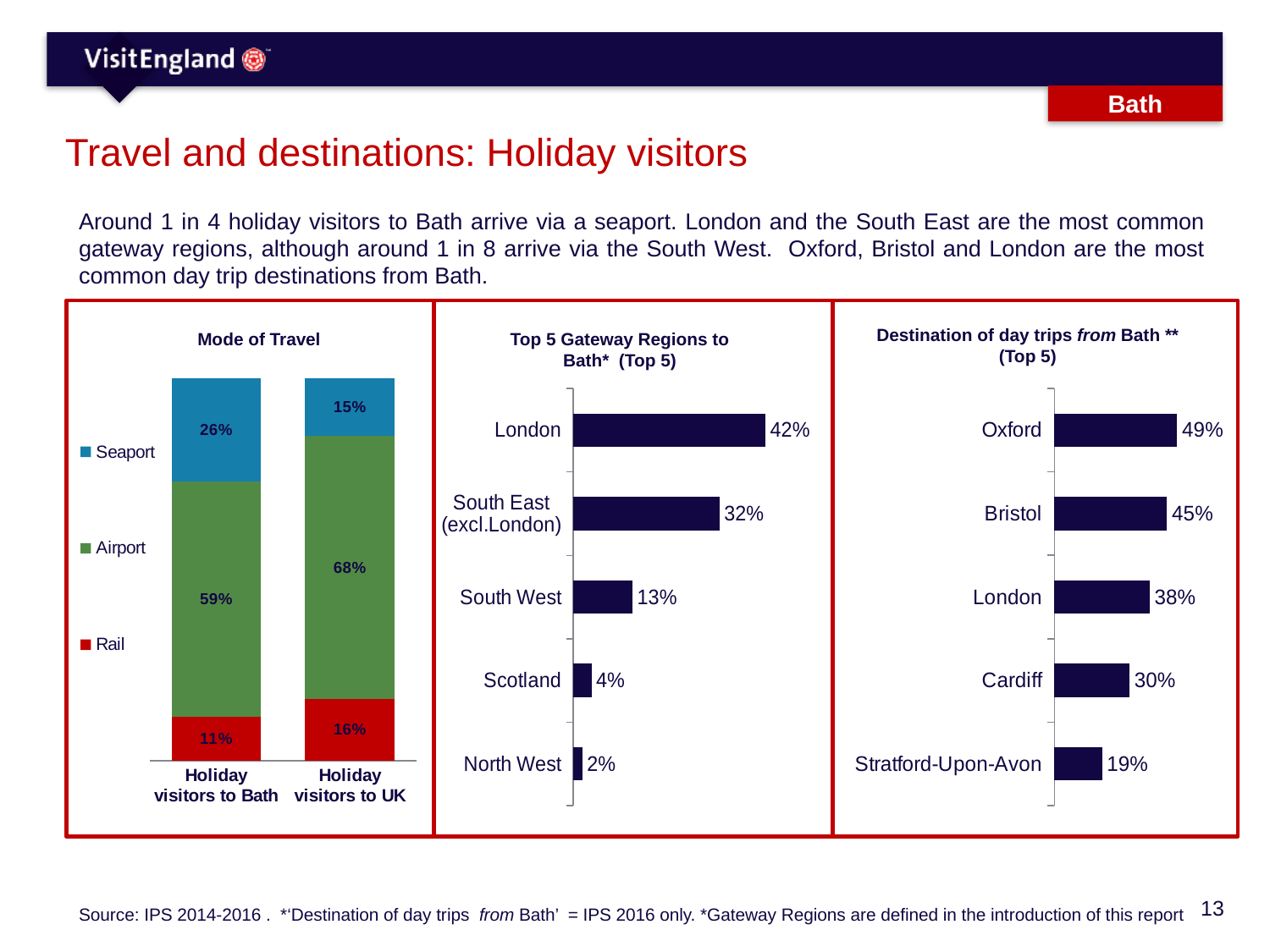
What kind of chart is the Destination of day trips from Bath chart? Bar chart In the Mode of Travel chart, what is the difference between the rail share for holiday visitors to UK and holiday visitors to Bath? 5% In the Destination of day trips from Bath chart, how many destinations are shown? 5 In the Mode of Travel chart, how many series does the legend list? 3 In the Top 5 Gateway Regions to Bath chart, what is the difference between London and South West? 29% In the Mode of Travel chart, what percentage of holiday visitors to Bath arrive by seaport? 26% In the Top 5 Gateway Regions to Bath chart, which region has the lowest value? North West In the Destination of day trips from Bath chart, what is the value for Cardiff? 30% In the Mode of Travel chart, what percentage of holiday visitors to UK arrive by airport? 68% In the Mode of Travel chart, which is larger: the seaport share for holiday visitors to Bath or for holiday visitors to UK? Holiday visitors to Bath In the Top 5 Gateway Regions to Bath chart, what is the value for South East (excl. London)? 32% In the Destination of day trips from Bath chart, which destination has the highest value? Oxford